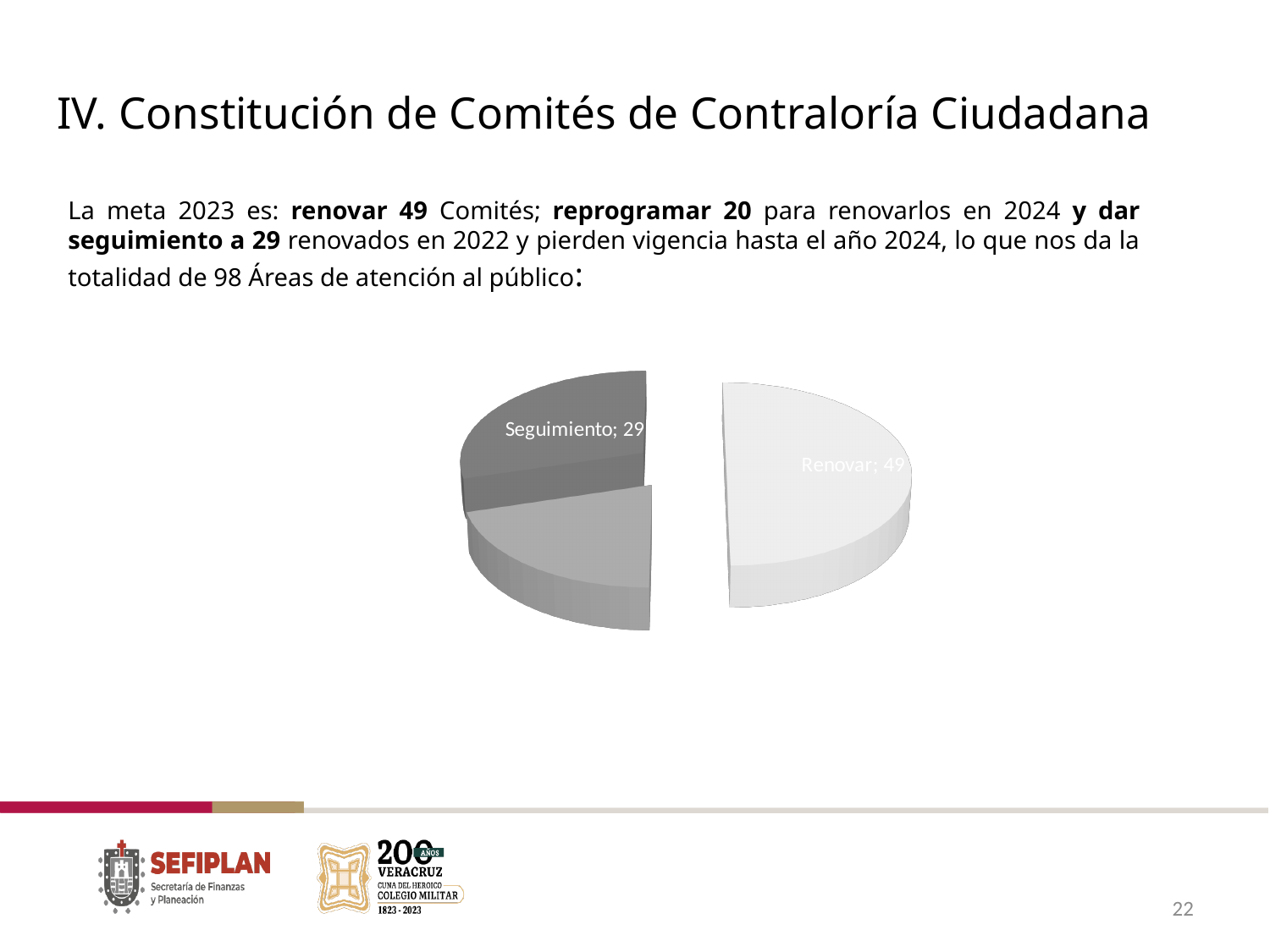
Which is larger in the pie chart, Renovar or Seguimiento? Renovar What is the value of the Renovar slice in the pie chart? 49 What is the difference between the Renovar and Seguimiento values in the pie chart? 20 What kind of chart is shown on the slide? pie chart Which labeled slice of the pie chart is drawn in the lightest colour? Renovar What is the value of the Seguimiento slice in the pie chart? 29 Which labeled slice of the pie chart has the largest value? Renovar How many slices in the pie chart have a data label? 2 How many slices does the pie chart have? 3